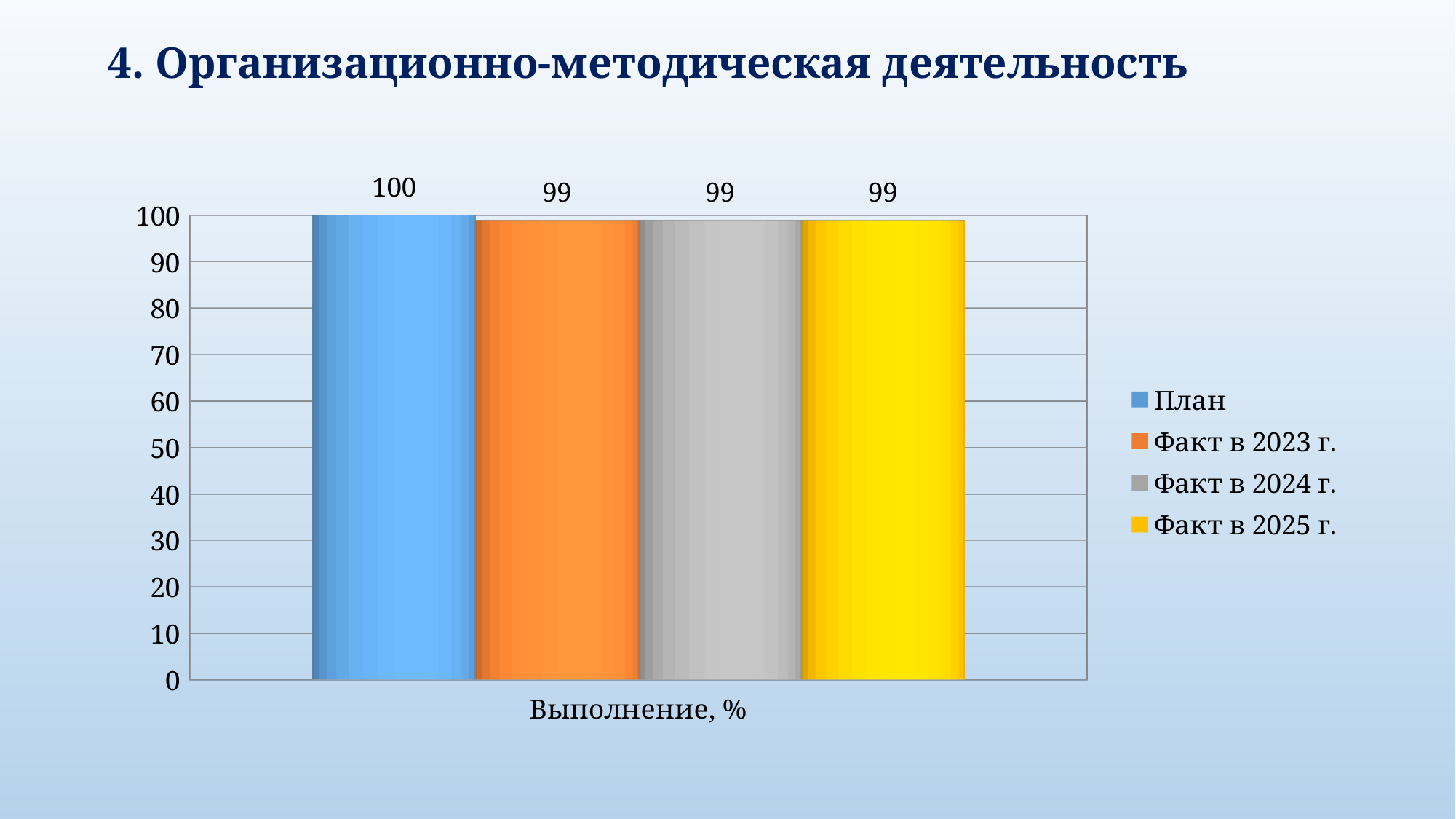
Which is larger, the value for План or the value for Факт в 2023 г.? План Which series has the highest value? План What is the label of the category on the x axis? Выполнение, % What kind of chart is shown on the slide? Bar chart What is the value of Факт в 2025 г.? 99 What is the value of Факт в 2023 г.? 99 What is the difference between the План value and the Факт в 2025 г. value? 1 How many series does the legend list? 4 What is the maximum value shown on the y axis? 100 What is the value of the План series? 100 What is the value of Факт в 2024 г.? 99 What colour is the bar for Факт в 2025 г.? Yellow